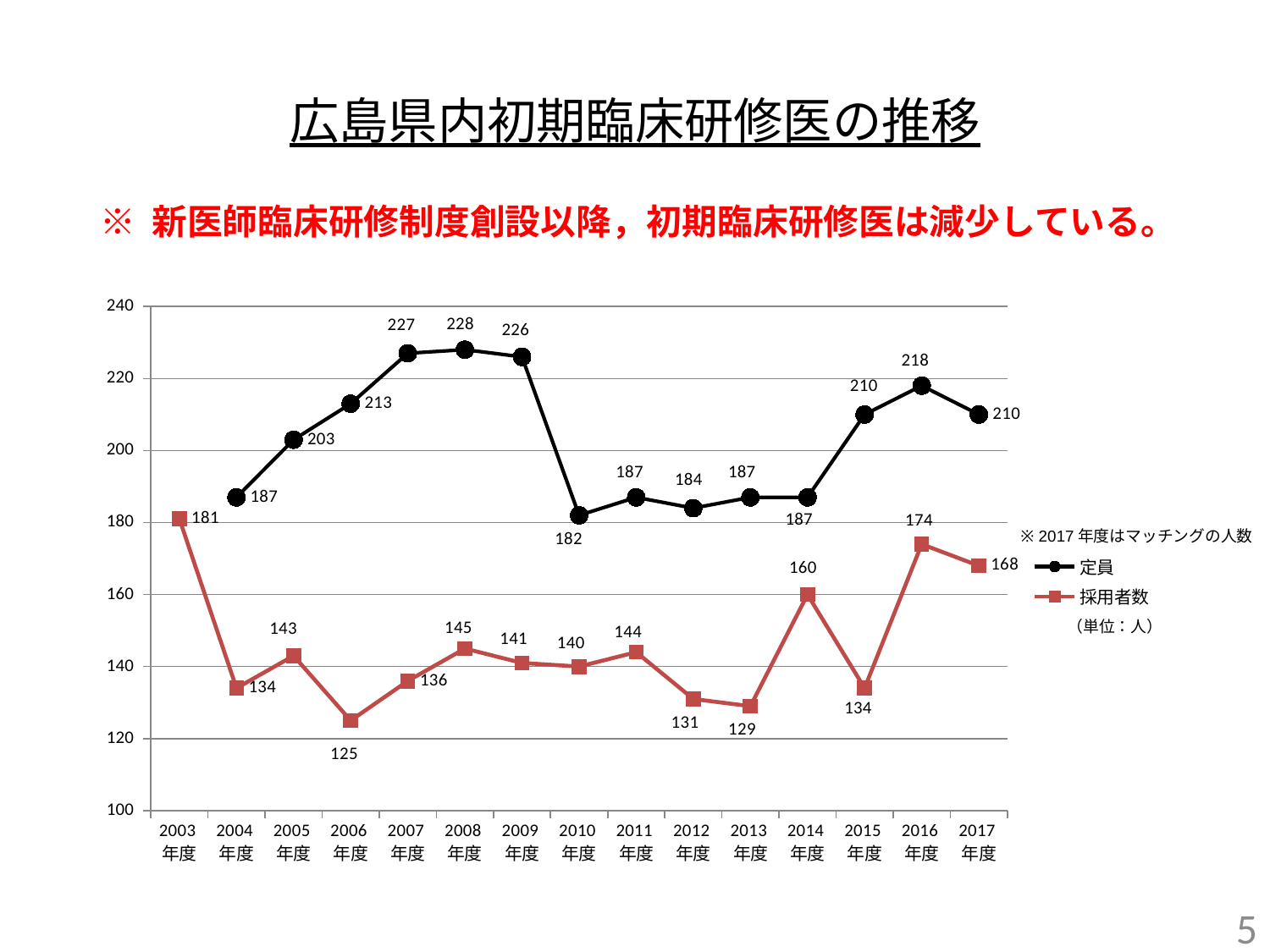
How many years are shown on the x axis? 15 Does 定員 rise or fall from 2004年度 to 2008年度? rise How many series does the legend list? 2 What is the difference between 定員 and 採用者数 in 2017年度? 42 Is the value of 定員 for 2010年度 greater or less than 200? less Which year has the lowest value for 採用者数? 2006年度 What is the value of 定員 for 2008年度? 228 What is the value of 採用者数 for 2016年度? 174 Which is larger, 採用者数 in 2014年度 or 採用者数 in 2015年度? 2014年度 What is the value of 採用者数 for 2003年度? 181 Which year has the highest value for 定員? 2008年度 What kind of chart is shown on the slide? line chart